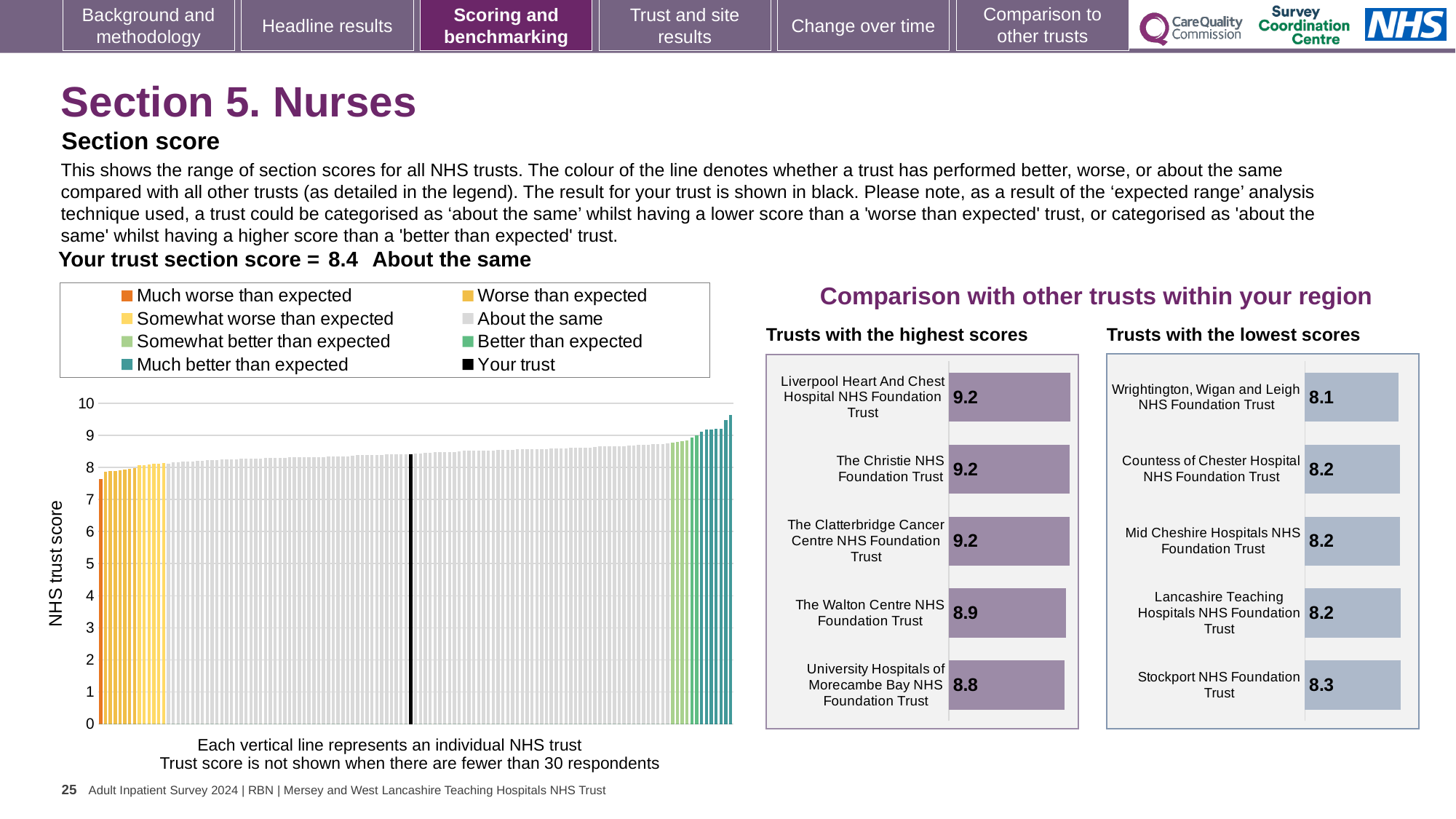
In the 'Trusts with the highest scores' chart, what is the score for Liverpool Heart And Chest Hospital NHS Foundation Trust? 9.2 In the large chart on the left, how many entries does the legend list? 8 In the large chart on the left, is the value for the black 'Your trust' bar greater or less than 8? greater In the 'Trusts with the lowest scores' chart, which trust has the highest score? Stockport NHS Foundation Trust What kind of chart is the large chart on the left showing NHS trust scores? bar chart In the large chart on the left, what is the label on the vertical axis? NHS trust score In the 'Trusts with the highest scores' chart, which trust has the lowest score? University Hospitals of Morecambe Bay NHS Foundation Trust In the 'Trusts with the lowest scores' chart, what is the score for Wrightington, Wigan and Leigh NHS Foundation Trust? 8.1 In the large chart on the left, is the value for the leftmost (orange) bar greater or less than 8? less How many trusts are shown in the 'Trusts with the lowest scores' chart? 5 In the 'Trusts with the highest scores' chart, what is the score for The Walton Centre NHS Foundation Trust? 8.9 In the 'Trusts with the highest scores' chart, what is the difference between the scores of The Christie NHS Foundation Trust and University Hospitals of Morecambe Bay NHS Foundation Trust? 0.4